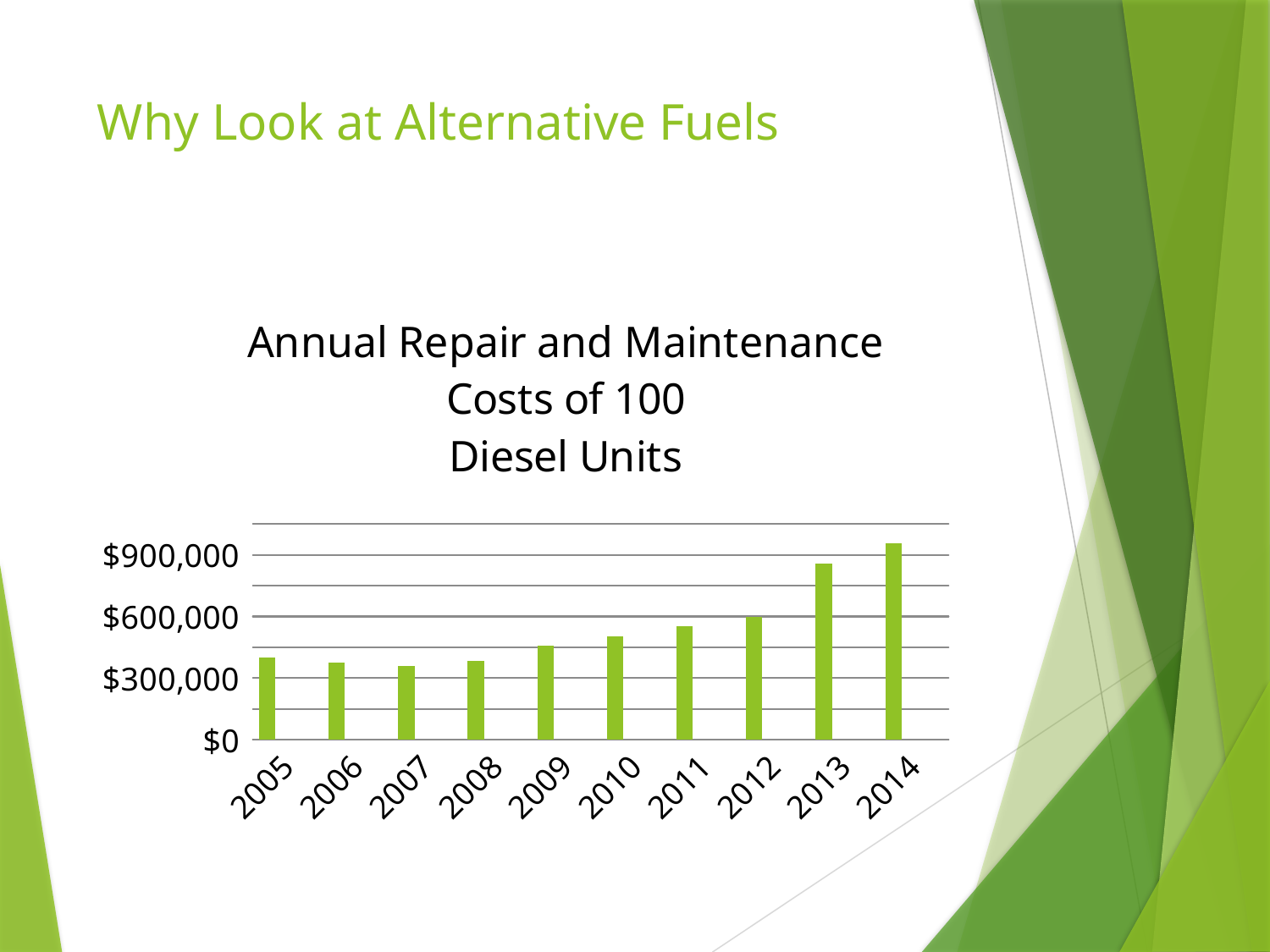
Do the annual repair and maintenance costs generally rise or fall from 2008 to 2014? Rise Is the value for 2013 greater or less than $900,000? less What kind of chart is shown on the slide? Bar chart Is the value for 2011 greater or less than $300,000? greater Which is larger, the value for 2013 or the value for 2009? 2013 Is the value for 2010 greater or less than $600,000? less What colour are the bars in the chart? Green How many years are plotted on the x axis of the chart? 10 Which year has the highest annual repair and maintenance cost? 2014 What is the title of the chart? Annual Repair and Maintenance Costs of 100 Diesel Units